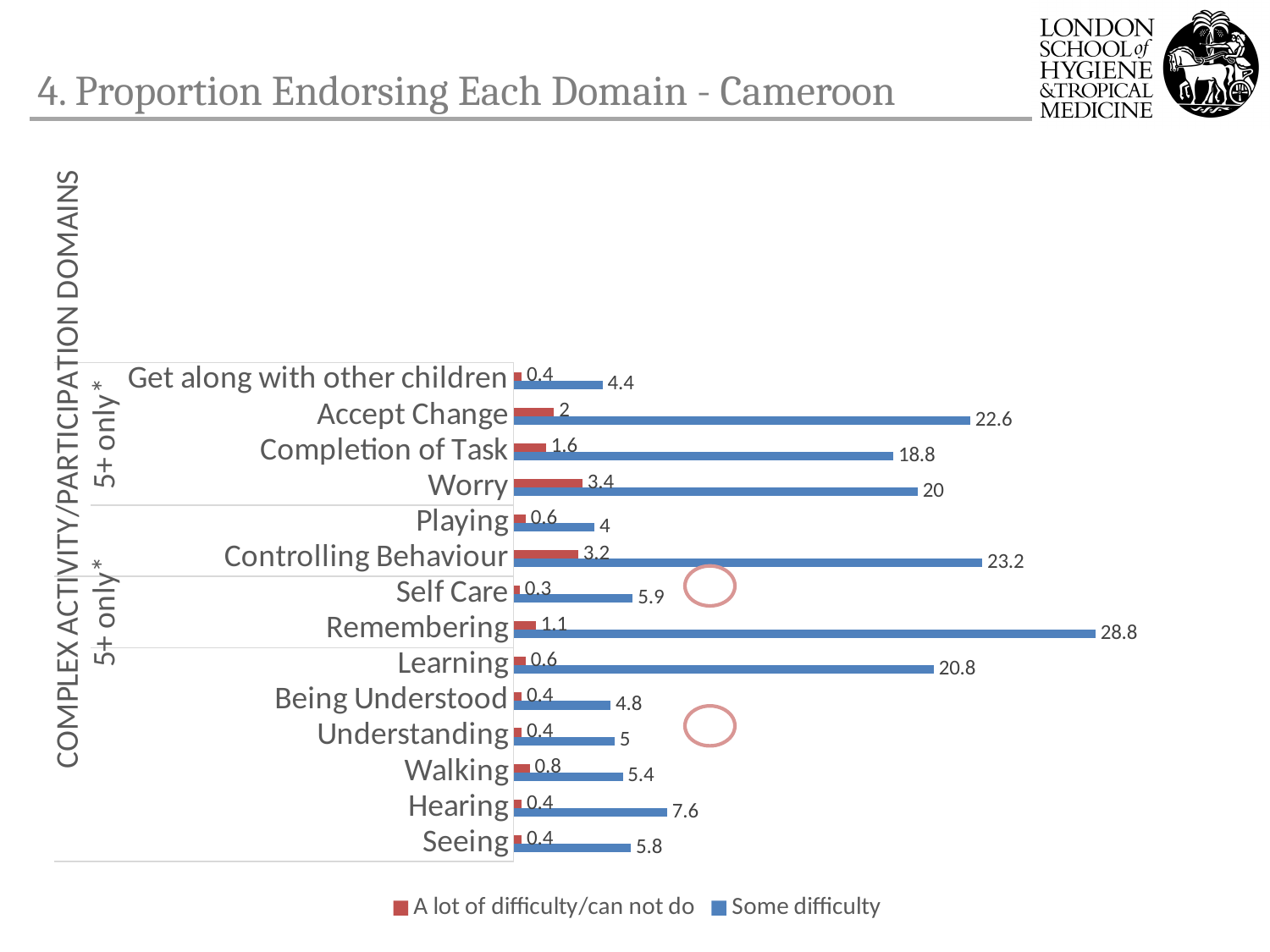
What type of chart is shown on the slide? bar chart Which domain has the highest 'Some difficulty' value? Remembering What is the title of the slide's chart? 4. Proportion Endorsing Each Domain - Cameroon How many domains (categories) are plotted in the chart? 14 Which domain has the lowest 'Some difficulty' value? Playing Which has a larger 'Some difficulty' value, Learning or Completion of Task? Learning What is the 'A lot of difficulty/can not do' value for Worry? 3.4 What is the difference between the 'Some difficulty' values for Controlling Behaviour and Accept Change? 0.6 Which domain has the lowest 'A lot of difficulty/can not do' value? Self Care What is the 'Some difficulty' value for Hearing? 7.6 How many series does the legend list? 2 What is the 'Some difficulty' value for Remembering? 28.8